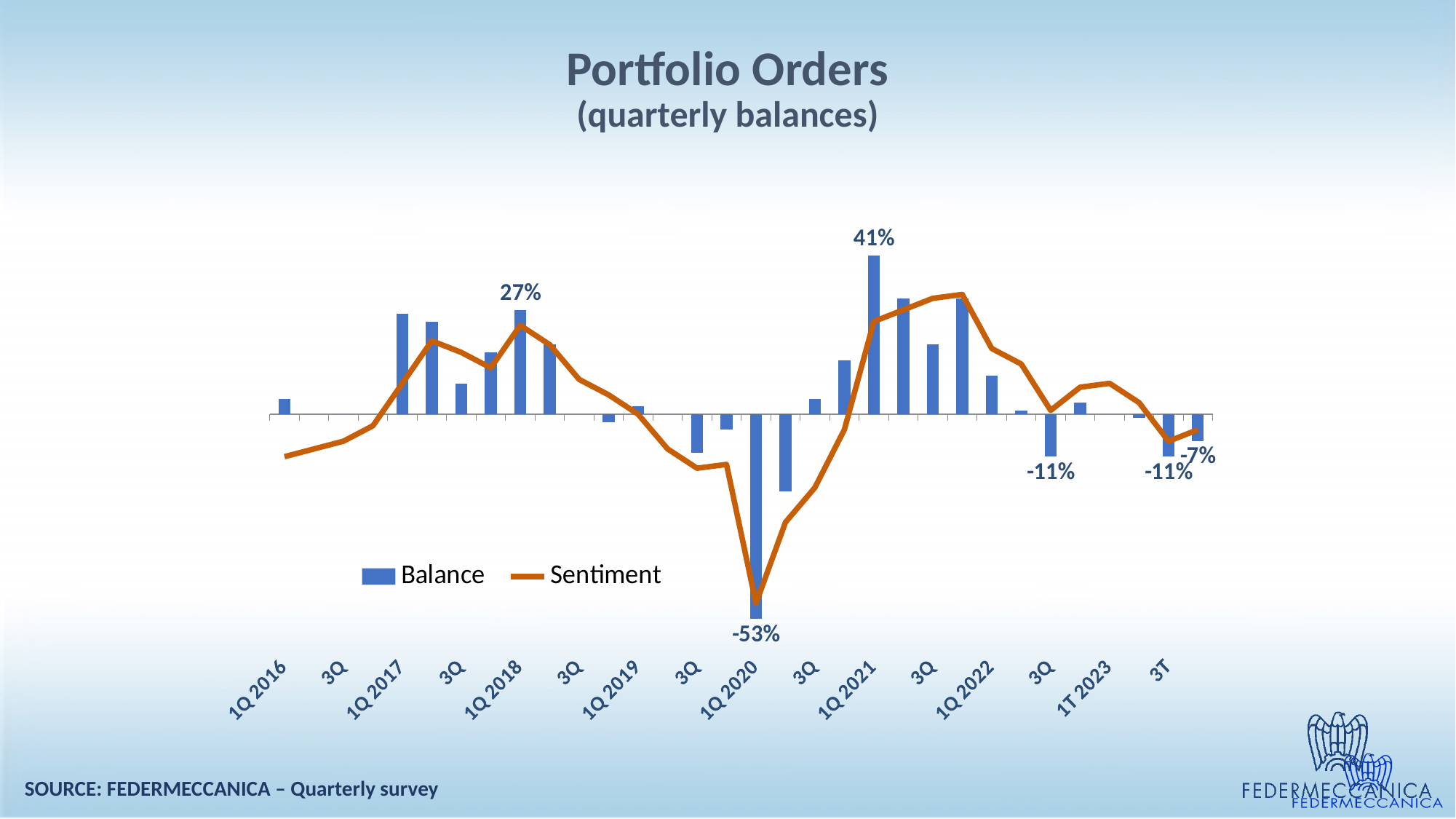
What kind of chart is shown on the slide? A bar chart combined with a line chart What is the difference between the Balance values for 1Q 2021 and 1Q 2018? 14 percentage points What is the Balance value for 3Q 2022? -11% How many series does the legend list? 2 What is the title of the chart? Portfolio Orders (quarterly balances) What is the Balance value for 1Q 2021? 41% Which quarter has the highest Balance value? 1Q 2021 What is the Balance value for 1Q 2020? -53% Which quarter has the lowest Balance value? 1Q 2020 Do the Balance bars rise or fall from 1Q 2021 to 3Q 2022? Fall What are the two series named in the legend? Balance and Sentiment What is the Balance value for 1Q 2018? 27%